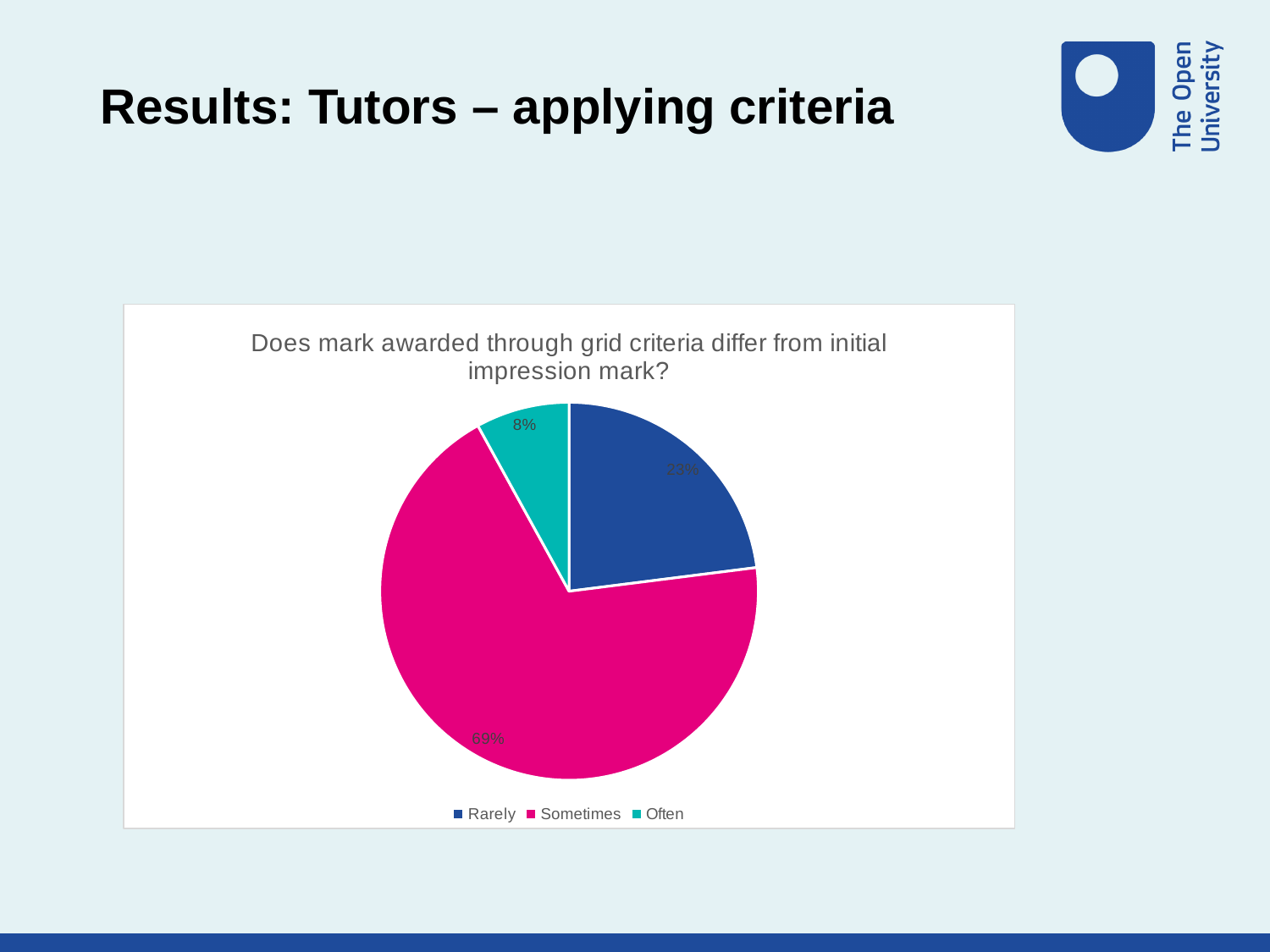
How many categories does the legend list? 3 What colour is the 'Sometimes' slice? pink What percentage of the pie is labelled 'Sometimes'? 69% Which is larger, the share for 'Rarely' or the share for 'Often'? Rarely What percentage of the pie is labelled 'Rarely'? 23% What is the difference in percentage points between 'Sometimes' and 'Rarely'? 46 What is the title of the chart? Does mark awarded through grid criteria differ from initial impression mark? What is the difference in percentage points between 'Rarely' and 'Often'? 15 What percentage of the pie is labelled 'Often'? 8% What type of chart is shown on the slide? pie chart Which category has the smallest share of the pie? Often Which category has the largest share of the pie? Sometimes